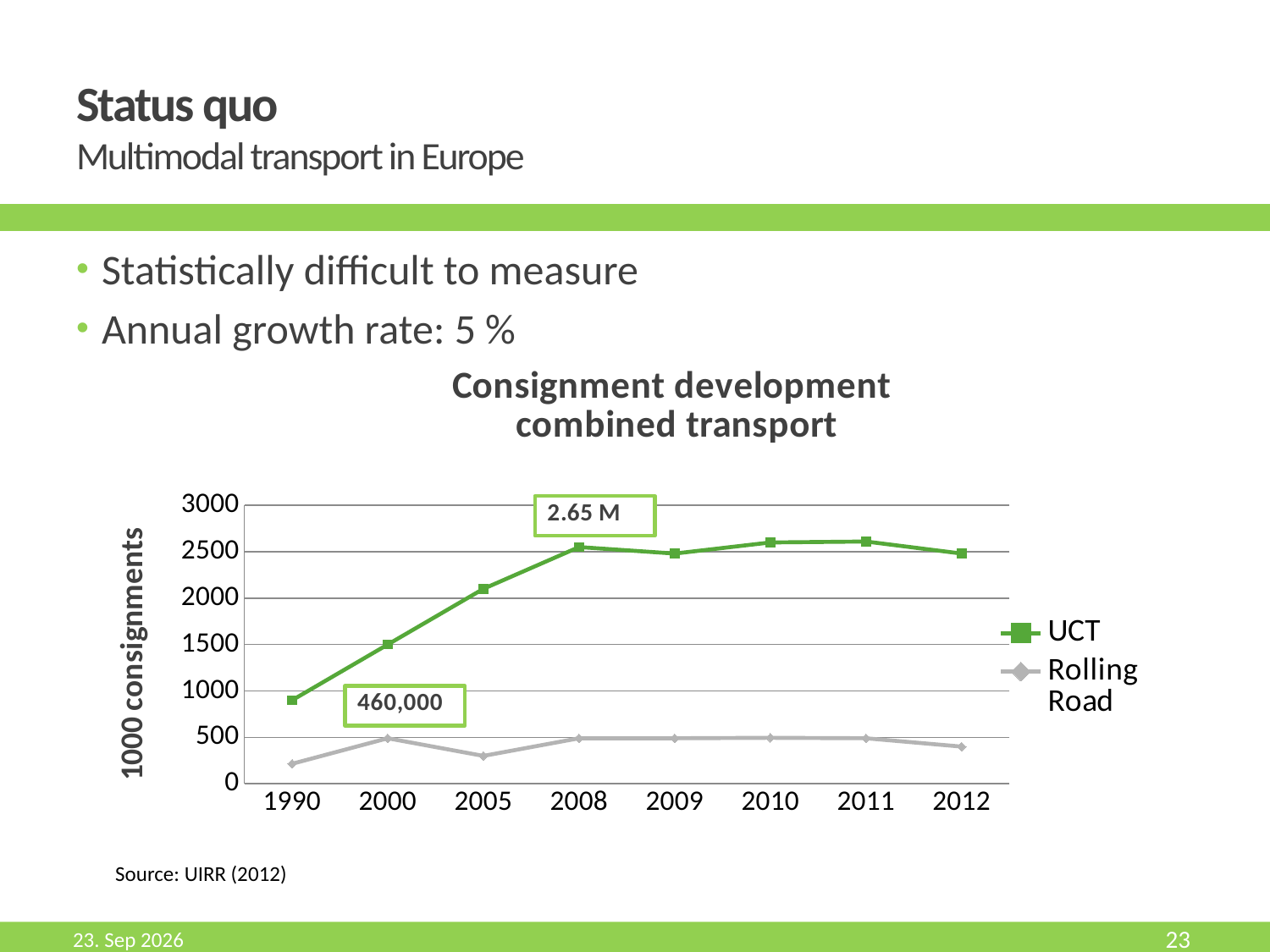
How many years are plotted along the x axis of the chart? 8 What kind of chart is shown on the slide? line chart Is the Rolling Road value for 2012 greater or less than 500? less What is the title of the chart? Consignment development combined transport Is the UCT value for 2005 greater or less than 2000? greater In 2012, which series has the larger value, UCT or Rolling Road? UCT Is the UCT value for 1990 greater or less than 1000? less What is the label on the vertical axis of the chart? 1000 consignments In which year is the Rolling Road series at its lowest value? 1990 Does the UCT series rise or fall between 1990 and 2008? rise In which year is the UCT series at its lowest value? 1990 How many series does the chart legend list? 2